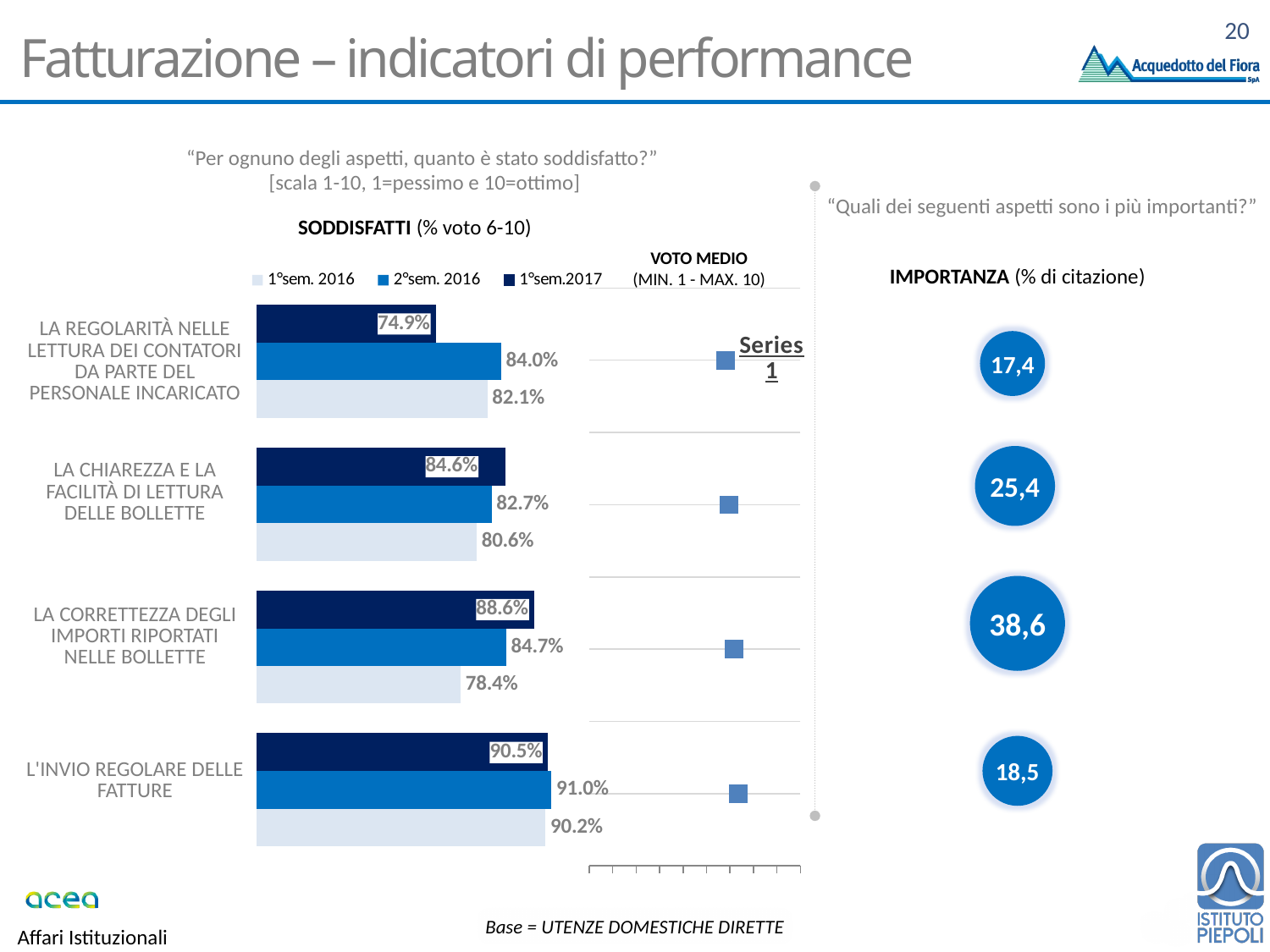
In the SODDISFATTI chart, what is the 1°sem. 2016 value for LA CHIAREZZA E LA FACILITÀ DI LETTURA DELLE BOLLETTE? 80.6% How many series does the legend of the SODDISFATTI chart list? 3 What kind of chart is the SODDISFATTI chart? Bar chart In the SODDISFATTI chart, which category has the highest 1°sem.2017 value? L'INVIO REGOLARE DELLE FATTURE In the SODDISFATTI chart, for LA REGOLARITÀ NELLE LETTURA DEI CONTATORI, which is larger: the 2°sem. 2016 value or the 1°sem.2017 value? 2°sem. 2016 In the SODDISFATTI chart, what is the 2°sem. 2016 value for LA CORRETTEZZA DEGLI IMPORTI RIPORTATI NELLE BOLLETTE? 84.7% In the SODDISFATTI chart, what is the 1°sem.2017 value for L'INVIO REGOLARE DELLE FATTURE? 90.5% How many categories are shown in the SODDISFATTI chart? 4 In the SODDISFATTI chart, what is the 1°sem.2017 value for LA REGOLARITÀ NELLE LETTURA DEI CONTATORI DA PARTE DEL PERSONALE INCARICATO? 74.9% In the SODDISFATTI chart, what is the difference between the 1°sem.2017 and 1°sem. 2016 values for LA CORRETTEZZA DEGLI IMPORTI RIPORTATI NELLE BOLLETTE? 10.2% In the IMPORTANZA (% di citazione) panel, which aspect has the highest value? LA CORRETTEZZA DEGLI IMPORTI RIPORTATI NELLE BOLLETTE In the SODDISFATTI chart, which category has the lowest 1°sem. 2016 value? LA CORRETTEZZA DEGLI IMPORTI RIPORTATI NELLE BOLLETTE